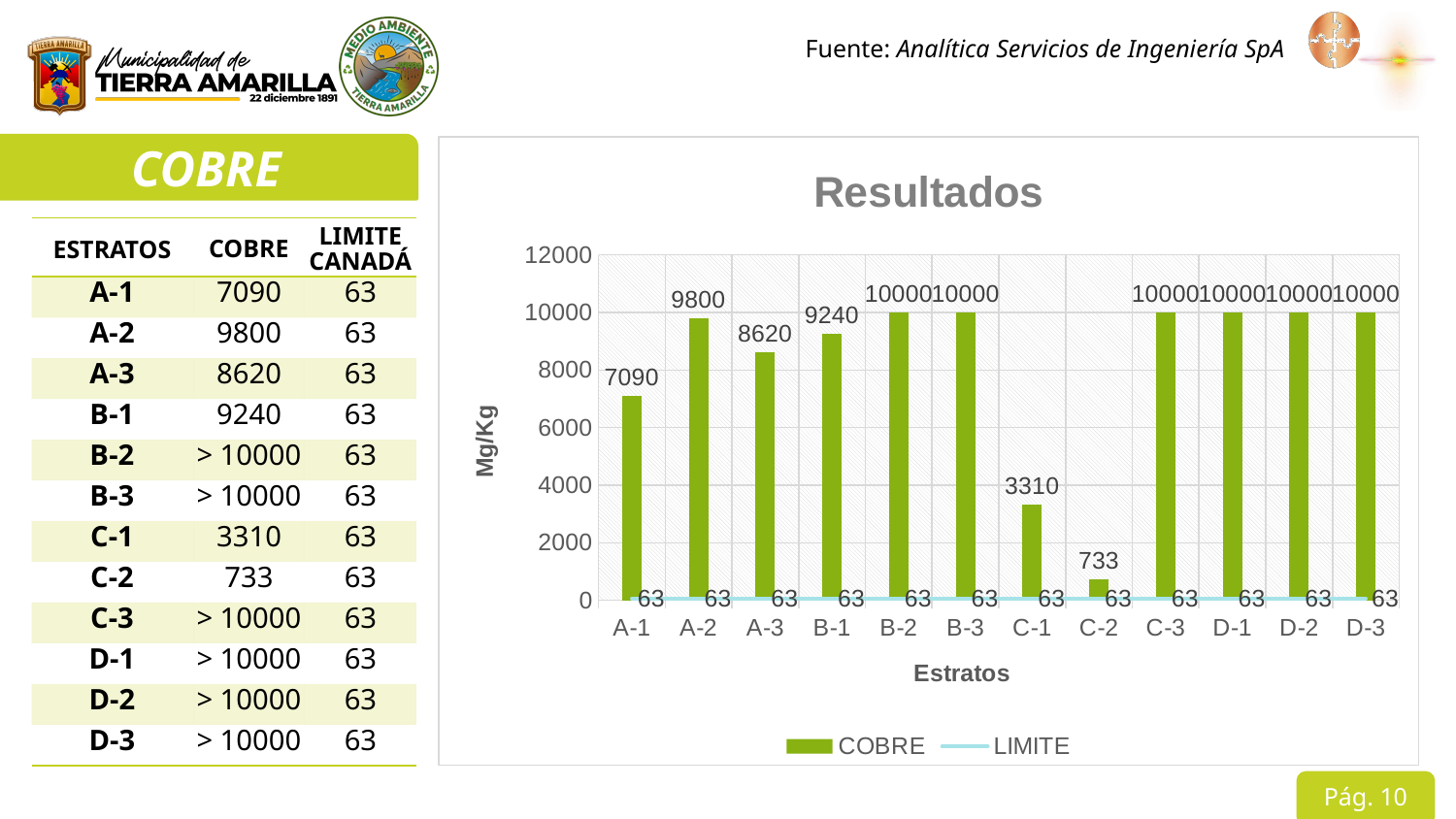
What is the COBRE value for A-1 in the Resultados chart? 7090 What is the y-axis label of the Resultados chart? Mg/Kg How many estratos are shown on the x axis of the Resultados chart? 12 Is the COBRE value for C-2 greater or less than 2000 in the Resultados chart? less Which has a higher COBRE value in the Resultados chart, B-1 or A-3? B-1 What kind of chart is the Resultados chart? Bar chart with a line series How many series does the legend of the Resultados chart list? 2 What is the COBRE value for C-1 in the Resultados chart? 3310 Which estrato has the lowest COBRE value in the Resultados chart? C-2 What is the difference between the COBRE values for A-2 and A-3 in the Resultados chart? 1180 What is the difference between the COBRE value for C-1 and the LIMITE value for C-1 in the Resultados chart? 3247 What is the LIMITE value shown for B-2 in the Resultados chart? 63